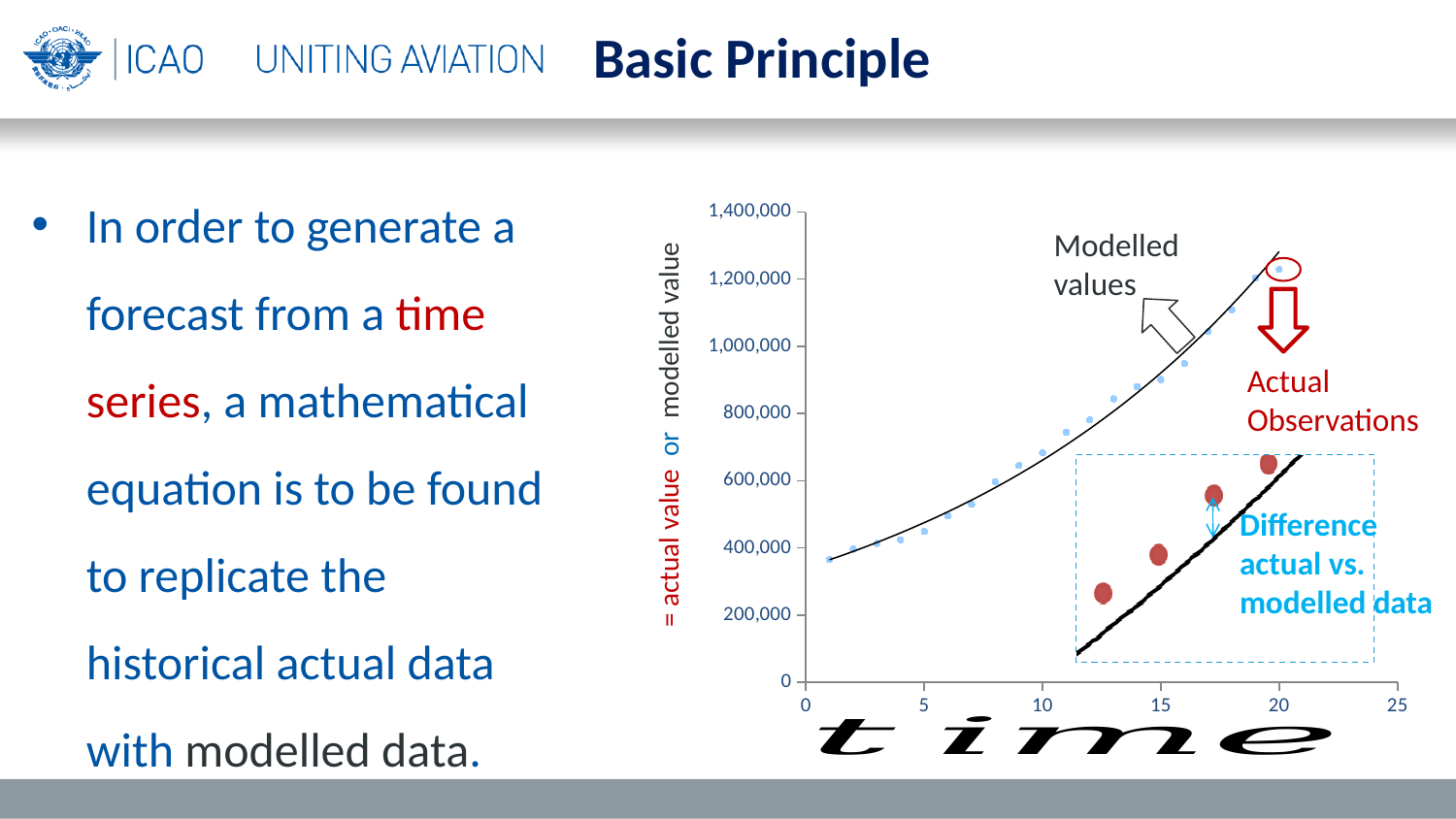
Which is larger, the plotted value at time 5 or the plotted value at time 15? time 15 Is the plotted value at time 5 greater or less than 600,000? less Do the plotted values rise or fall as time increases along the x axis? rise Is the plotted value at time 15 greater or less than 800,000? greater At which time value does the highest plotted point occur? 20 Is the plotted value at time 1 greater or less than 400,000? less At which time value does the lowest plotted point occur? 1 What is the highest value shown on the y axis? 1,400,000 What is the label of the x axis of the chart? time What kind of chart is shown on the slide? scatter chart